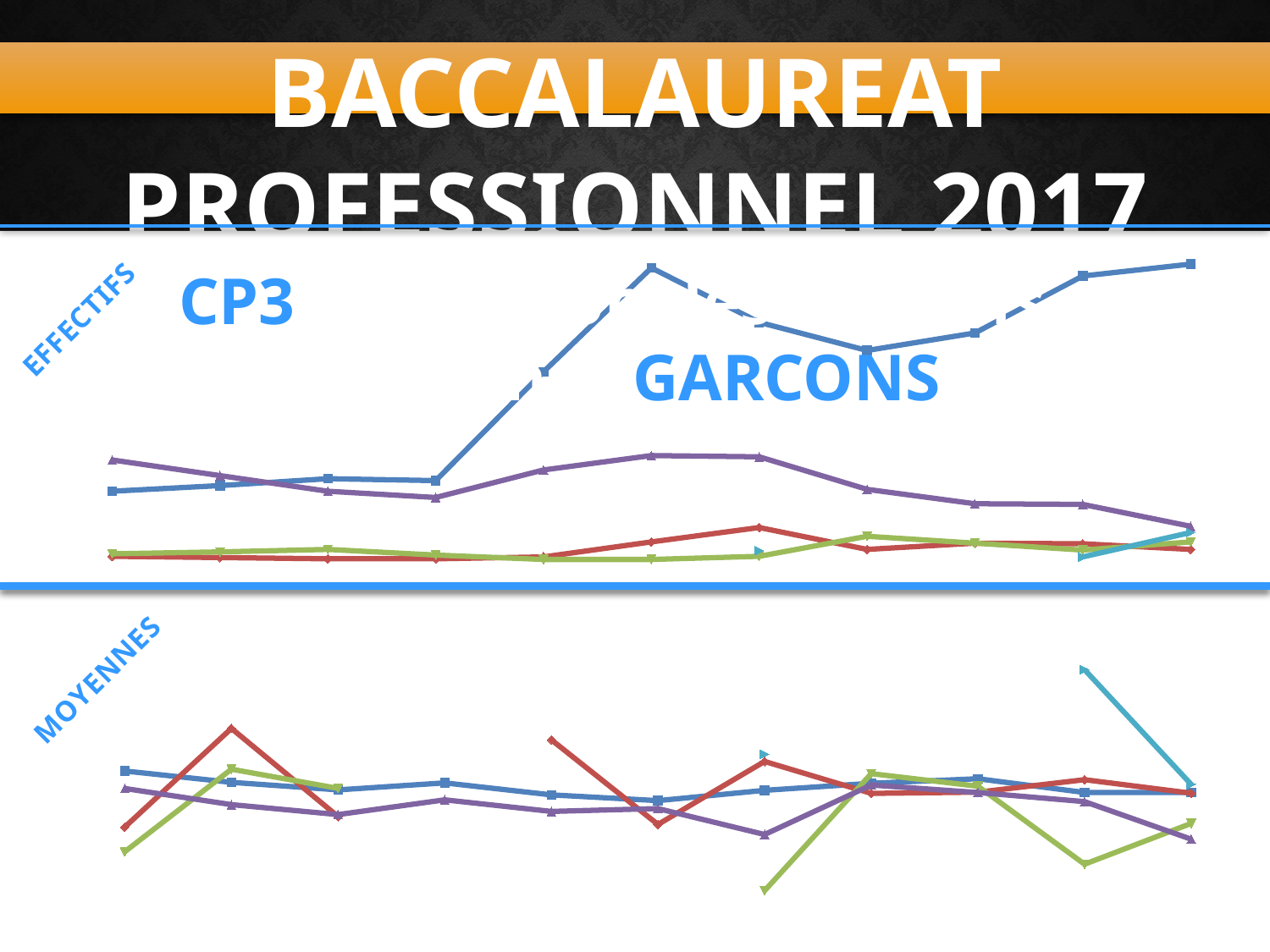
What kind of chart is the bottom chart labelled MOYENNES? line chart In the top chart (EFFECTIFS), does the blue line rise or fall overall from left to right? rise What label is written vertically at the left of the top chart? EFFECTIFS What kind of chart is the top chart labelled EFFECTIFS? line chart In the top chart (EFFECTIFS), which coloured line reaches the highest point? the blue line What label is written vertically at the left of the bottom chart? MOYENNES